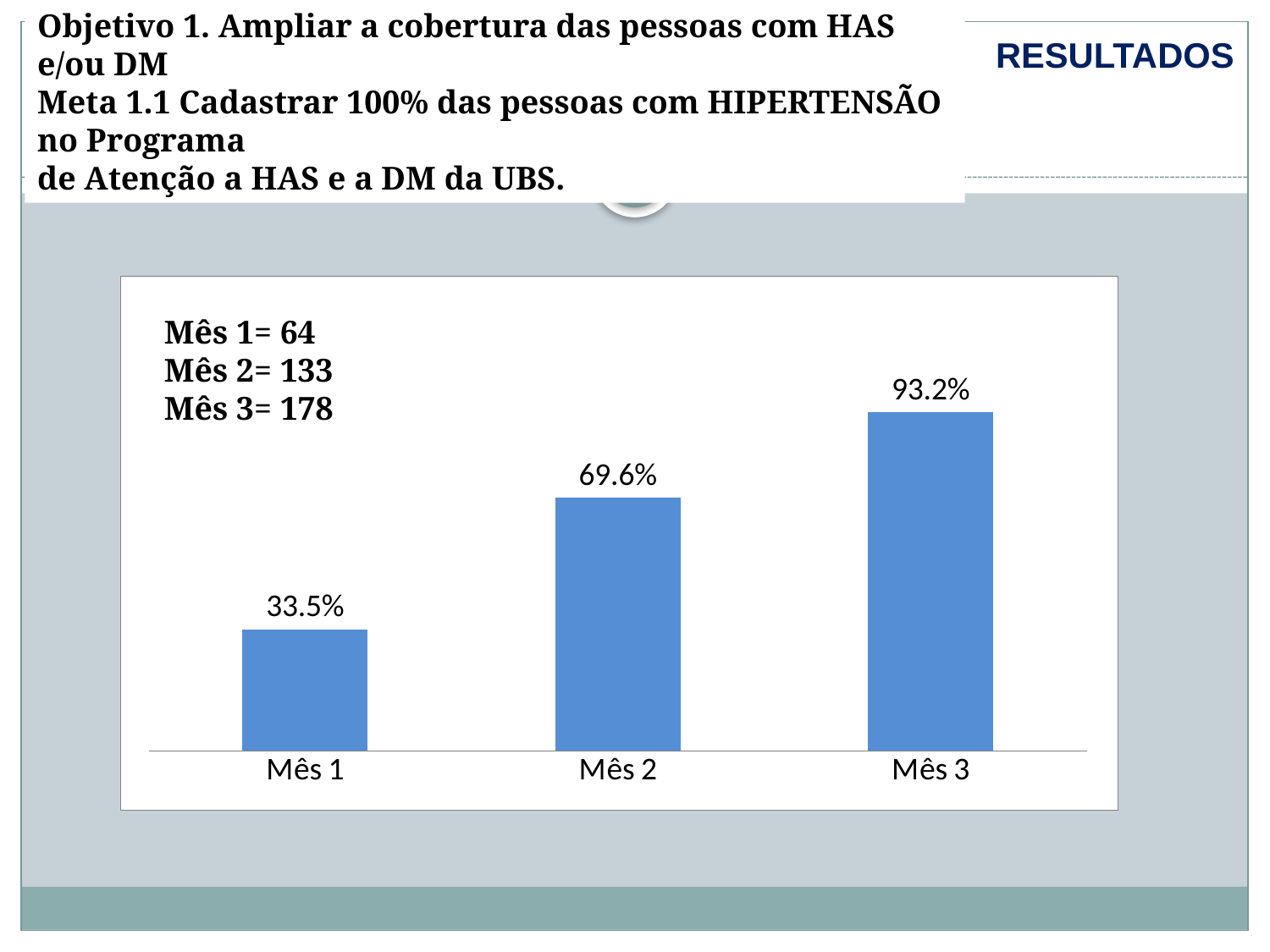
How many bars are shown in the chart? 3 According to the text inside the chart, how many people were registered in Mês 3? 178 Which month has the highest value? Mês 3 What is the difference between the values for Mês 2 and Mês 1? 36.1% What is the difference between the values for Mês 3 and Mês 1? 59.7% What is the value for Mês 1? 33.5% Do the values rise or fall from Mês 1 to Mês 3? Rise What kind of chart is shown on the slide? Bar chart Which is larger, the value for Mês 2 or the value for Mês 3? Mês 3 What is the value for Mês 2? 69.6% What is the value for Mês 3? 93.2% Which month has the lowest value? Mês 1